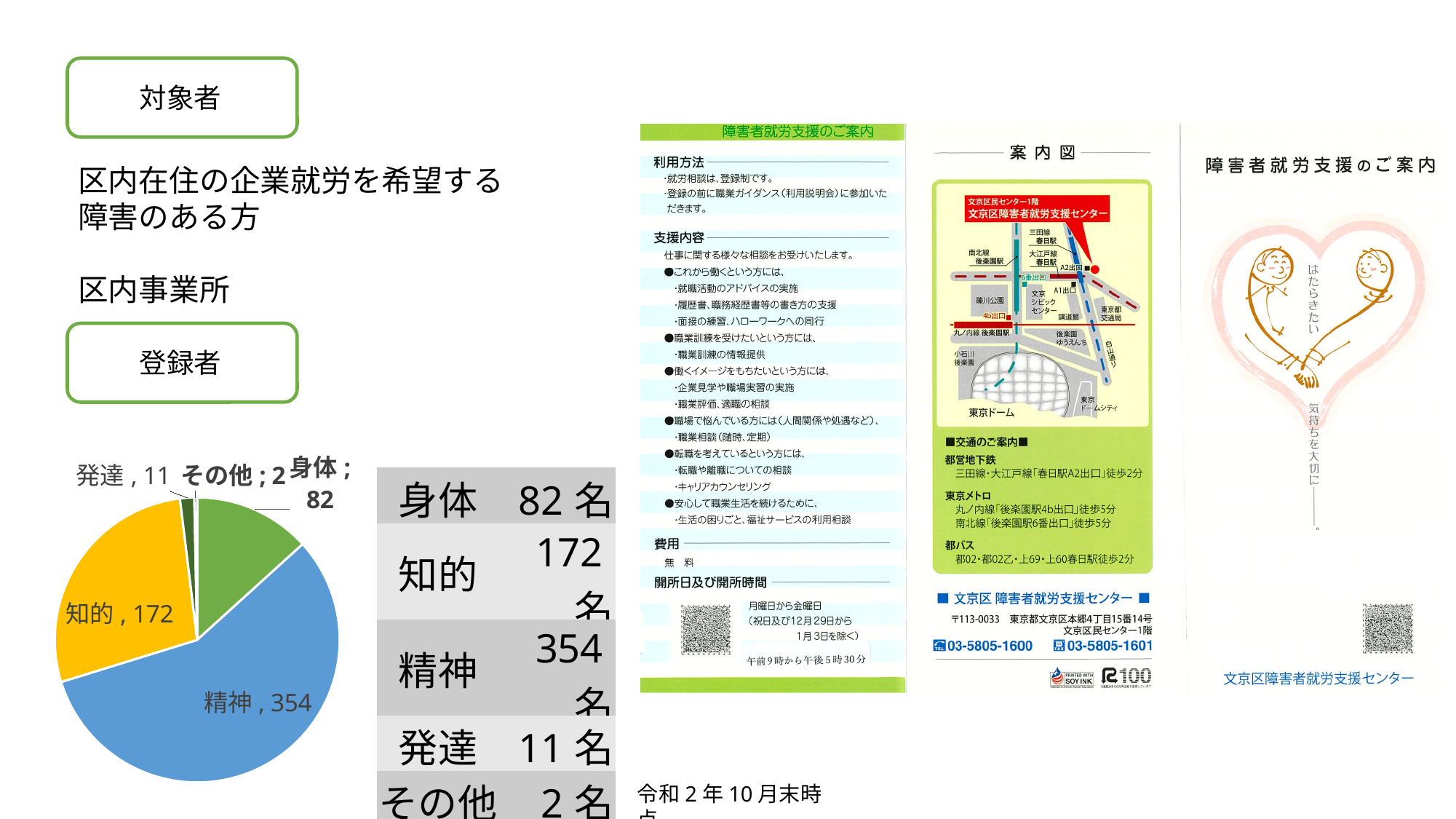
What kind of chart is shown on the slide? pie chart What is the total of all slices in the pie chart? 621 What is the value for 発達 in the pie chart? 11 What is the difference between the values for 精神 and 知的 in the pie chart? 182 What is the value for 知的 in the pie chart? 172 Which is larger in the pie chart, 知的 or 身体? 知的 Which category has the largest slice in the pie chart? 精神 What is the value for その他 in the pie chart? 2 Which category has the smallest slice in the pie chart? その他 How many slices does the pie chart have? 5 What is the value for 精神 in the pie chart? 354 What is the value for 身体 in the pie chart? 82